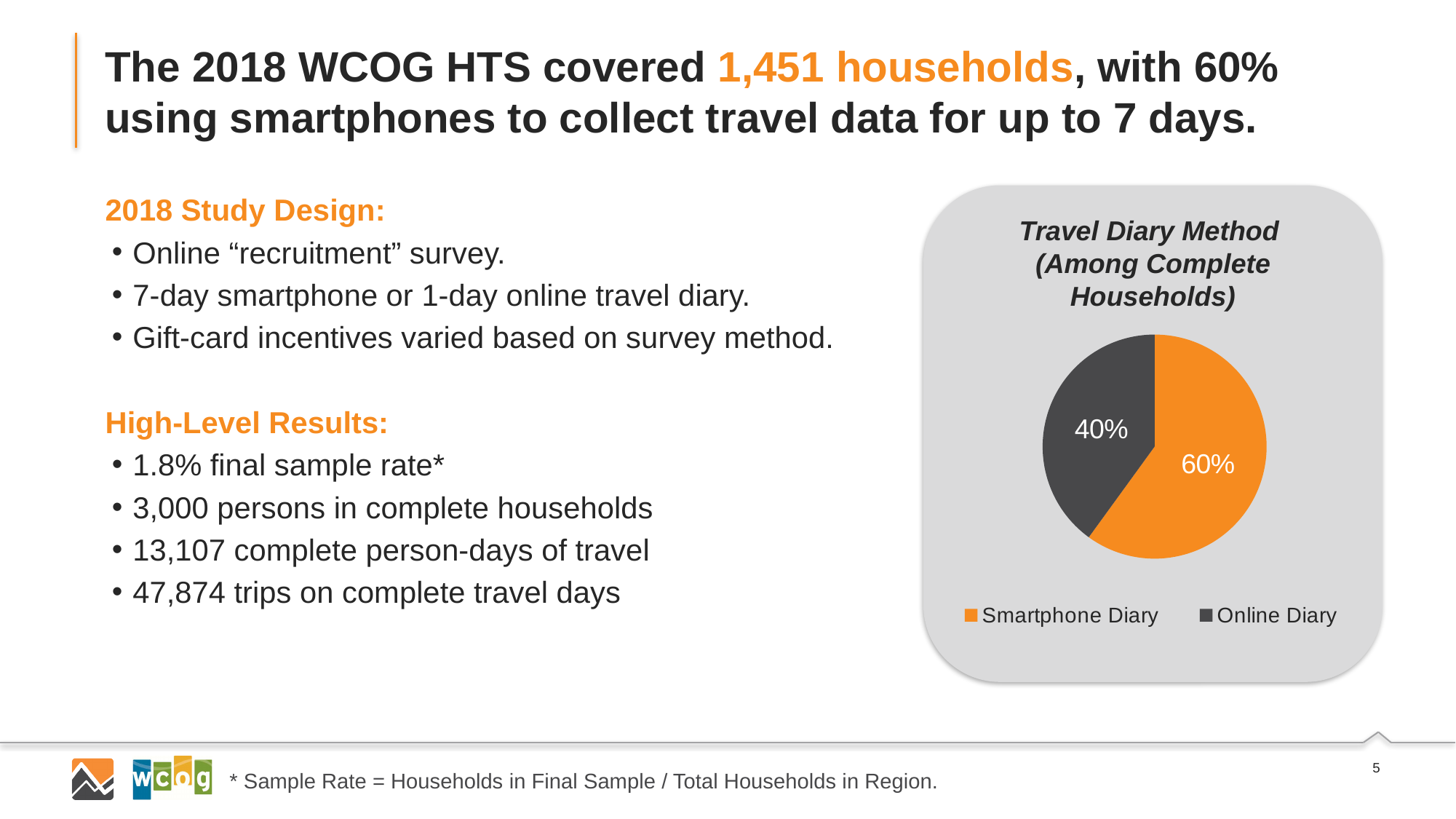
Which is larger, the Smartphone Diary share or the Online Diary share? Smartphone Diary Which colour represents the Online Diary slice in the pie chart? dark grey What is the title of the chart? Travel Diary Method (Among Complete Households) What share of complete households used the Online Diary? 40% Which travel diary method has the smallest share of the pie? Online Diary What kind of chart is shown on the slide? pie chart What share of complete households used the Smartphone Diary? 60% What is the difference in percentage points between the Smartphone Diary and Online Diary shares? 20% Which travel diary method has the largest share of the pie? Smartphone Diary How many entries does the chart legend list? 2 How many slices does the pie chart have? 2